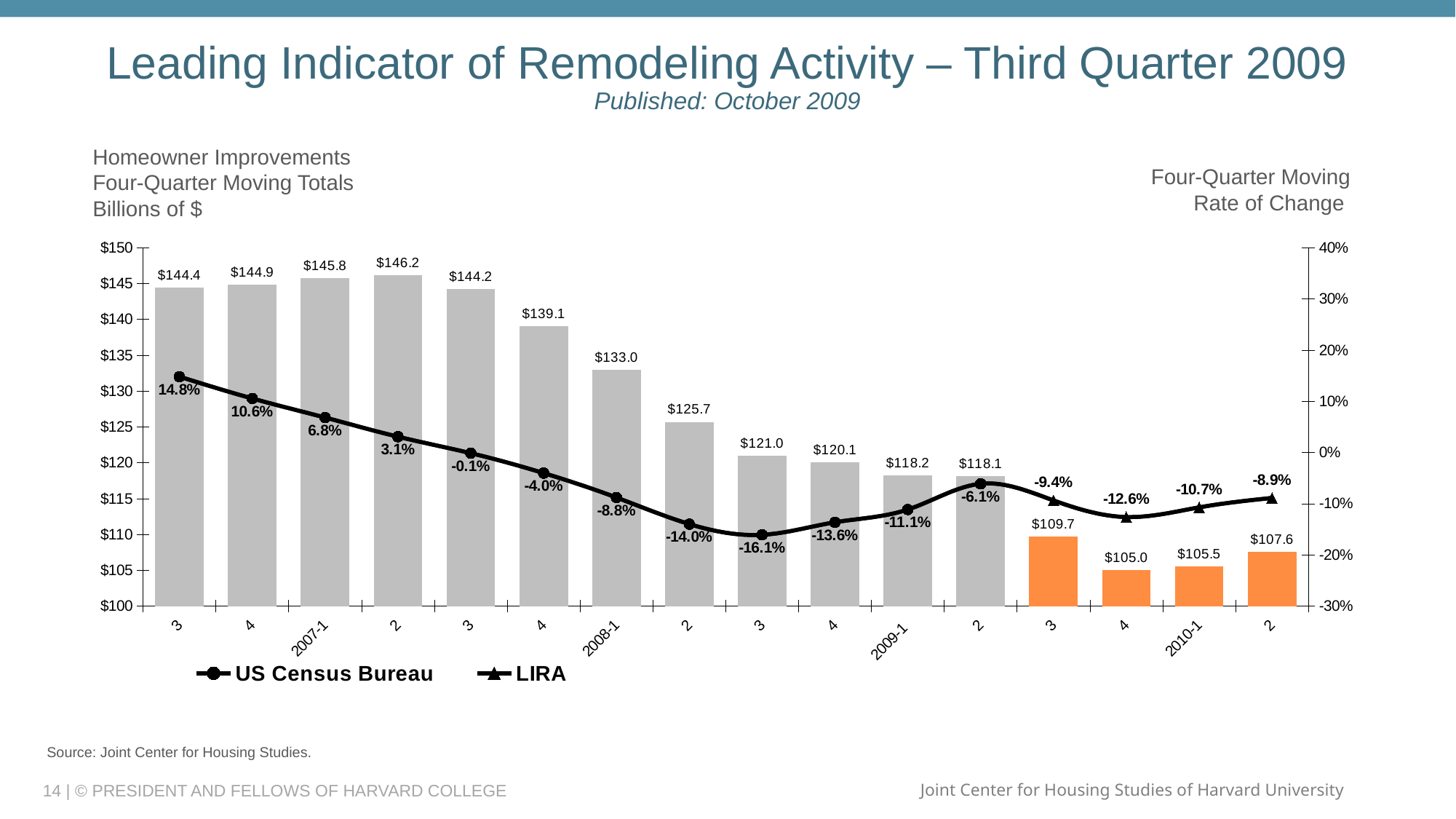
How many quarters (bars) are plotted on the chart? 16 What is the lowest four-quarter moving rate of change shown on the line? -16.1% Which quarter has the highest four-quarter moving total bar? 2 (the quarter after 2007-1) Which quarter has the lowest four-quarter moving total bar? 4 (the quarter before 2010-1) What is the LIRA rate of change for 2010-1? -10.7% What is the difference between the four-quarter moving totals for 2008-1 and 2009-1? $14.8 Which is larger, the four-quarter moving total for 2009-1 or for 2010-1? 2009-1 What is the four-quarter moving total for 2010-1? $105.5 What is the four-quarter moving total for 2007-1? $145.8 What is the four-quarter moving rate of change for 2008-1? -8.8% How many series does the legend list? 2 What is the four-quarter moving total for 2009-1? $118.2